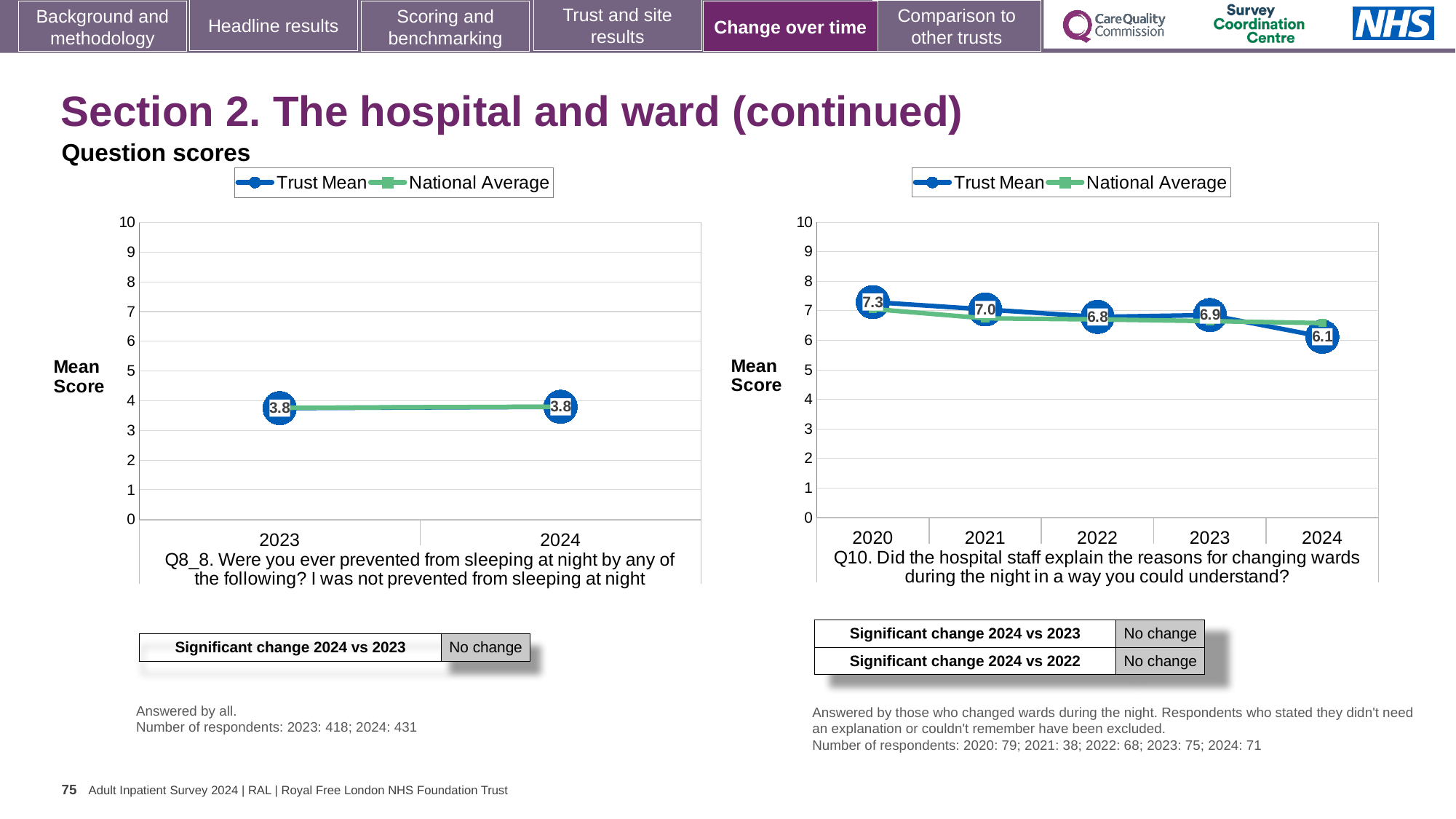
On the Q8_8 chart (left), how many series does the legend list? 2 On the Q10 chart (right), what is the Trust Mean score for 2024? 6.1 On the Q8_8 chart (left), what is the Trust Mean score for 2024? 3.8 On the Q10 chart (right), which year has the highest Trust Mean score? 2020 On the Q10 chart (right), what is the Trust Mean score for 2020? 7.3 On the Q10 chart (right), does the Trust Mean generally rise or fall from 2020 to 2024? fall On the Q8_8 chart (left), what is the Trust Mean score for 2023? 3.8 On the Q10 chart (right), which year has the lowest Trust Mean score? 2024 On the Q10 chart (right), what is the difference between the Trust Mean scores for 2020 and 2024? 1.2 What type of chart is the Q10 chart (right)? line chart On the Q8_8 chart (left), how many years are plotted on the x axis? 2 On the Q8_8 chart (left), is the Trust Mean for 2024 greater or less than 5? less